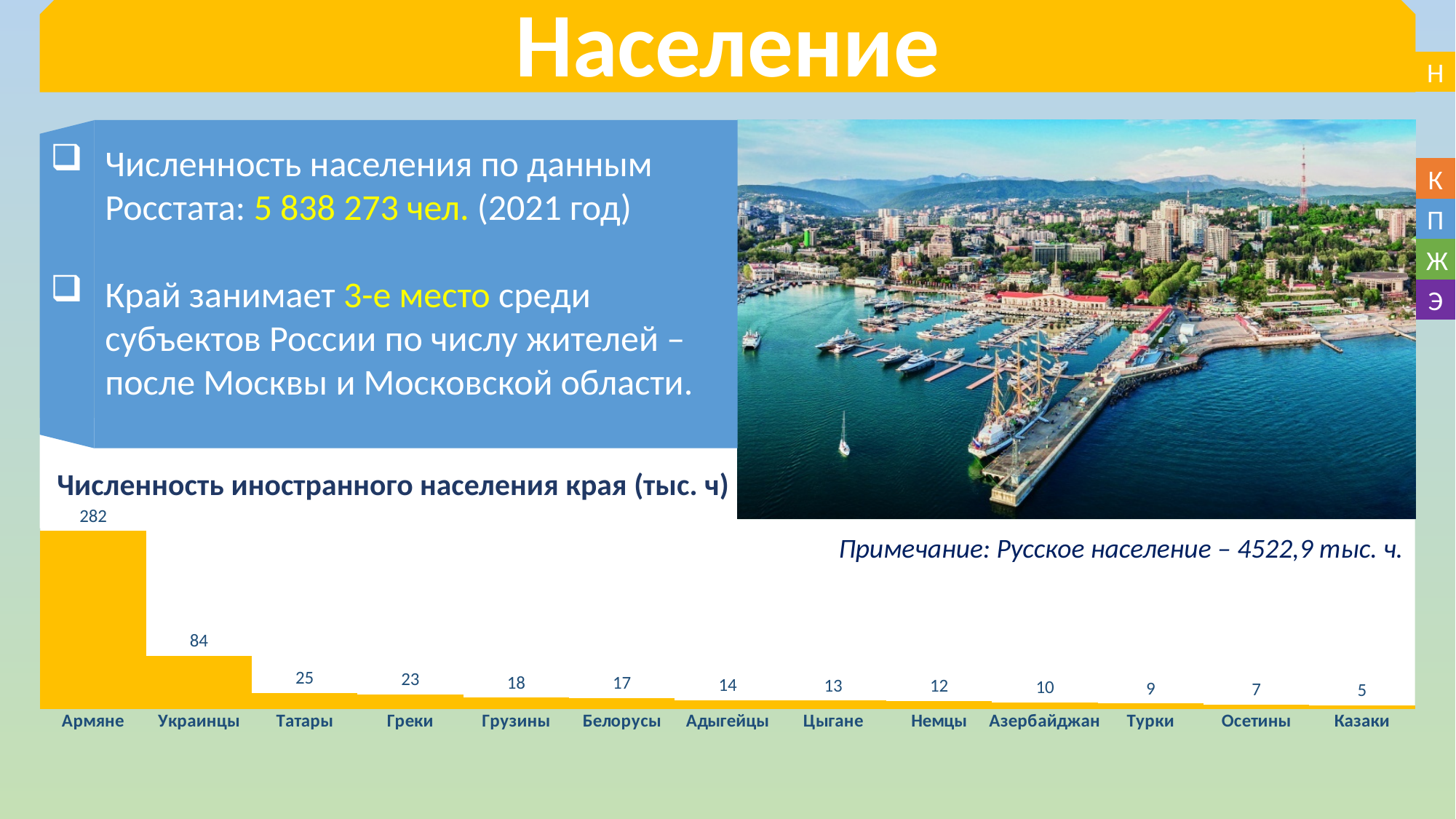
What is the difference between the values for Татары and Греки? 2 What is the difference between the values for Армяне and Украинцы? 198 How many categories are shown in the chart? 13 Which is larger, the value for Белорусы or the value for Немцы? Белорусы What is the value for Азербайджан in the chart? 10 What is the title of the chart on the slide? Численность иностранного населения края (тыс. ч) What is the value for Армяне in the chart 'Численность иностранного населения края (тыс. ч)'? 282 Which category has the highest value in the chart? Армяне What is the value for Украинцы in the chart? 84 Which category has the lowest value in the chart? Казаки What is the value for Грузины in the chart? 18 What kind of chart is shown on the slide? Bar chart